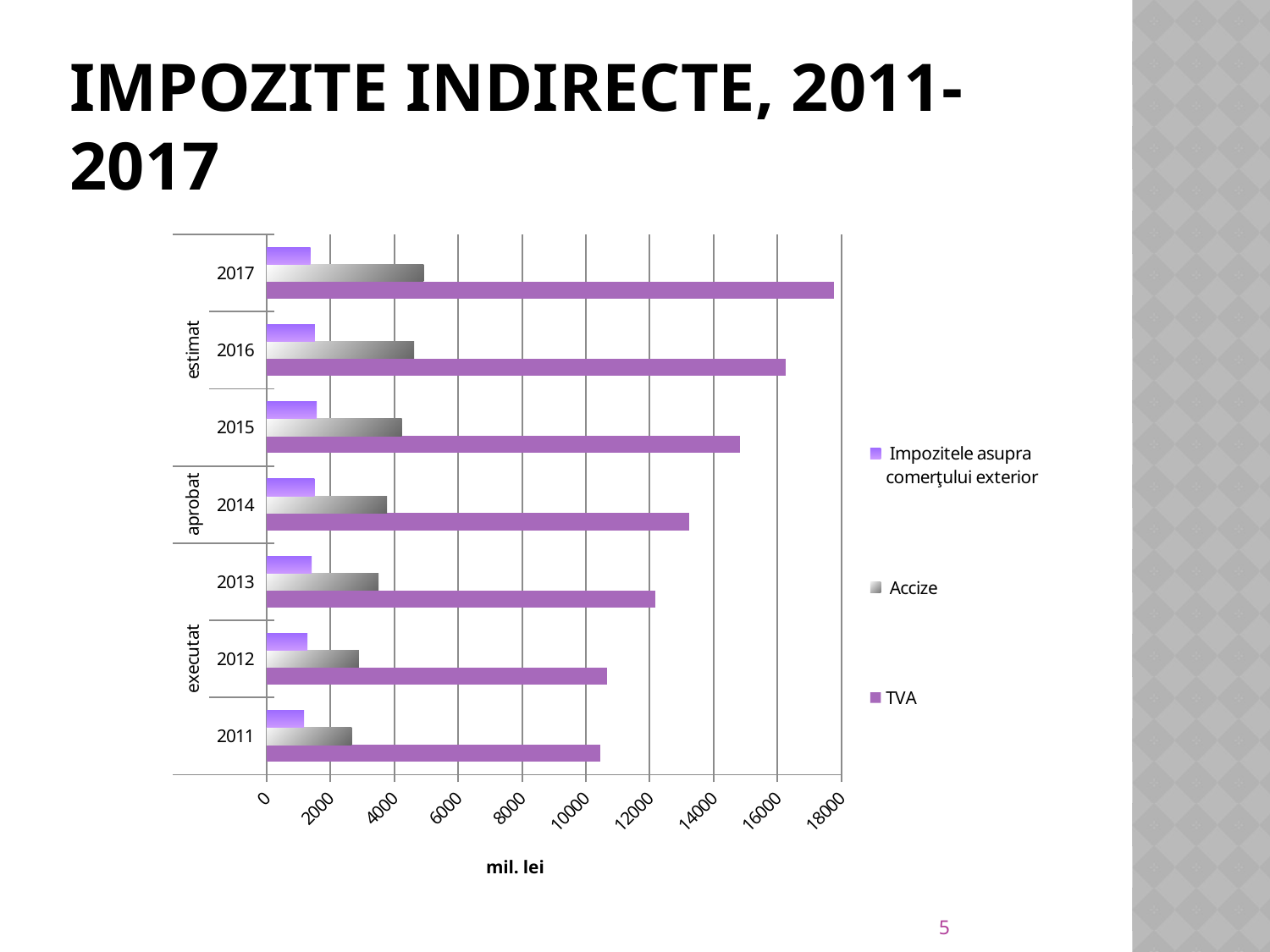
Do the TVA values rise or fall from 2011 to 2017? rise What unit is given on the horizontal axis title? mil. lei How many series does the legend list? 3 Which is larger in 2017, the Accize value or the Impozitele asupra comerţului exterior value? Accize Which year has the highest Accize value? 2017 Is the TVA value for 2017 greater or less than 16000? greater How many years are shown on the chart? 7 Which year has the highest TVA value? 2017 Is the Accize value for 2011 greater or less than 4000? less Is the Accize value for 2017 greater or less than 4000? greater What kind of chart is shown on the slide? bar chart